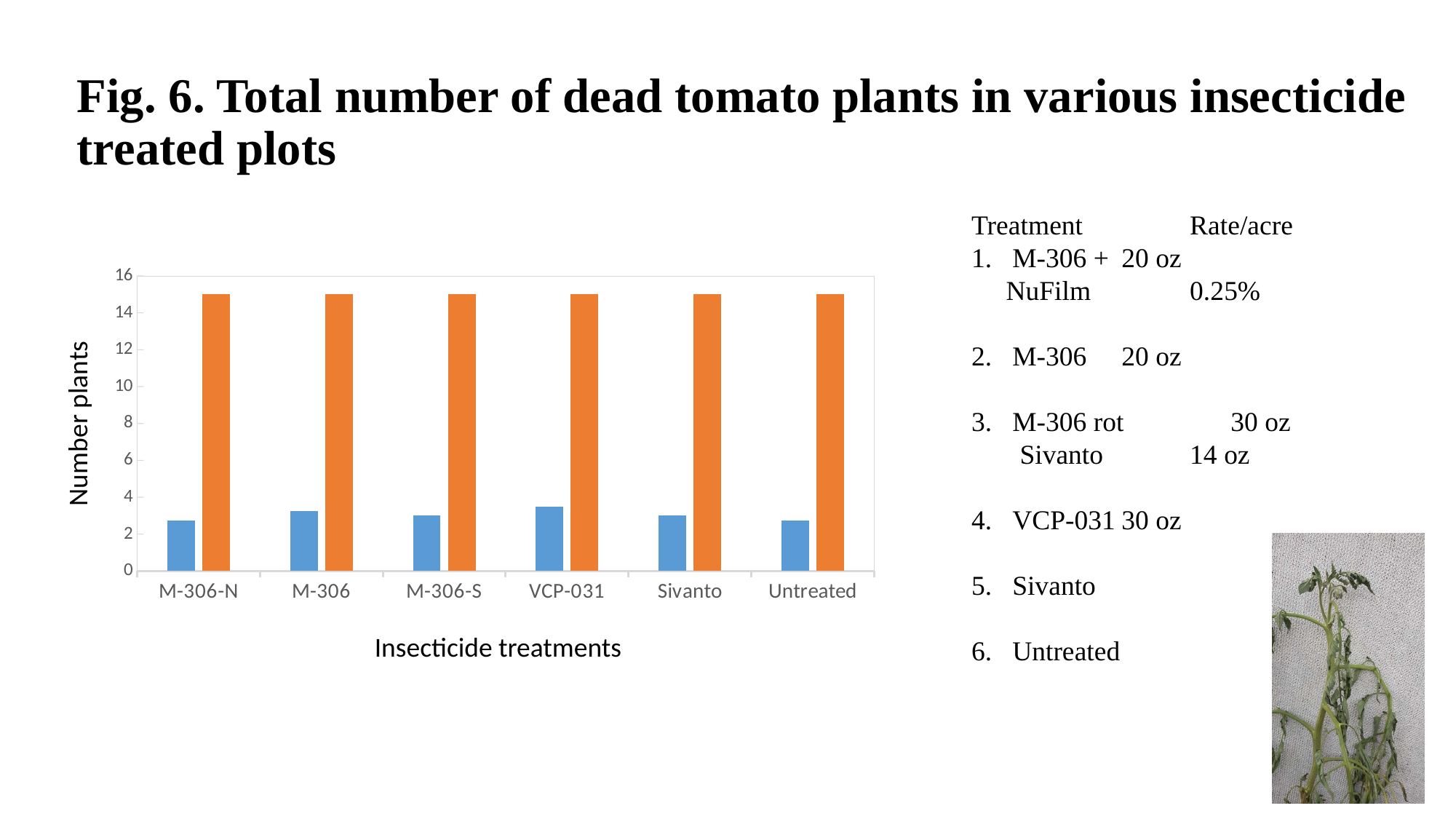
Is the value of the blue bar for M-306-N greater or less than 2? greater Which treatment has the highest blue bar in the chart? VCP-031 What is the label of the vertical axis of the chart? Number plants Is the value of the blue bar for Sivanto greater or less than 6? less Is the value of the orange bar for M-306 greater or less than 16? less How many insecticide treatment categories are shown on the x axis of the chart? 6 How many bars are plotted for each treatment category in the chart? 2 Which is larger for Sivanto, the blue bar or the orange bar? the orange bar What kind of chart is shown on the slide? bar chart Which is larger, the blue bar for VCP-031 or the blue bar for M-306-N? VCP-031